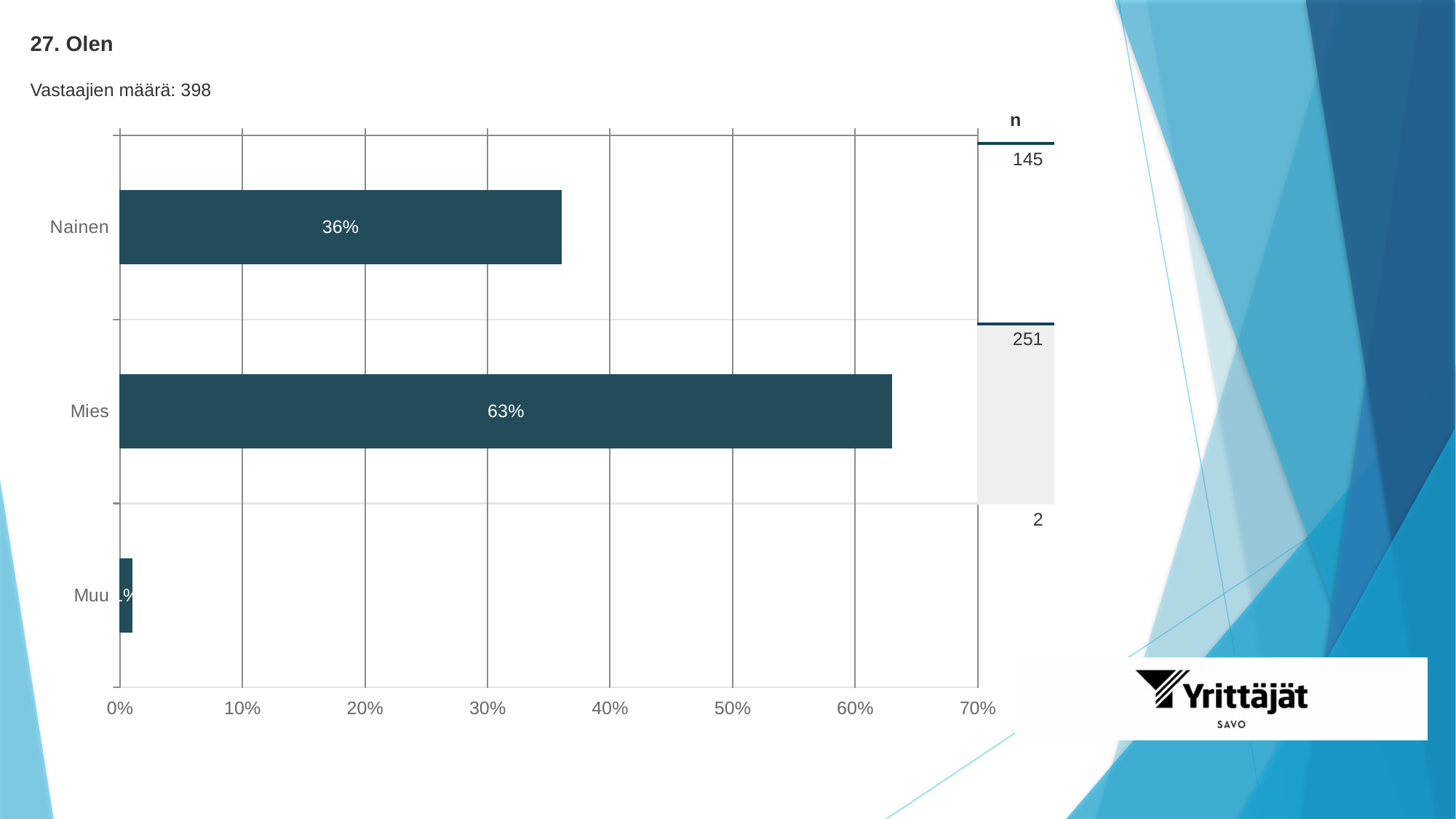
Is the value for Muu greater or less than 10%? less What is the difference in percentage points between Mies and Nainen? 27 Which category has the lowest percentage? Muu Which category has the highest percentage? Mies What kind of chart is shown on the slide? bar chart How many categories are shown in the chart? 3 What is the n value shown for Mies? 251 What is the n value shown for Muu? 2 What is the n value shown for Nainen? 145 Which is larger, the percentage for Nainen or for Mies? Mies What percentage is shown for Mies? 63% What percentage is shown for Nainen? 36%